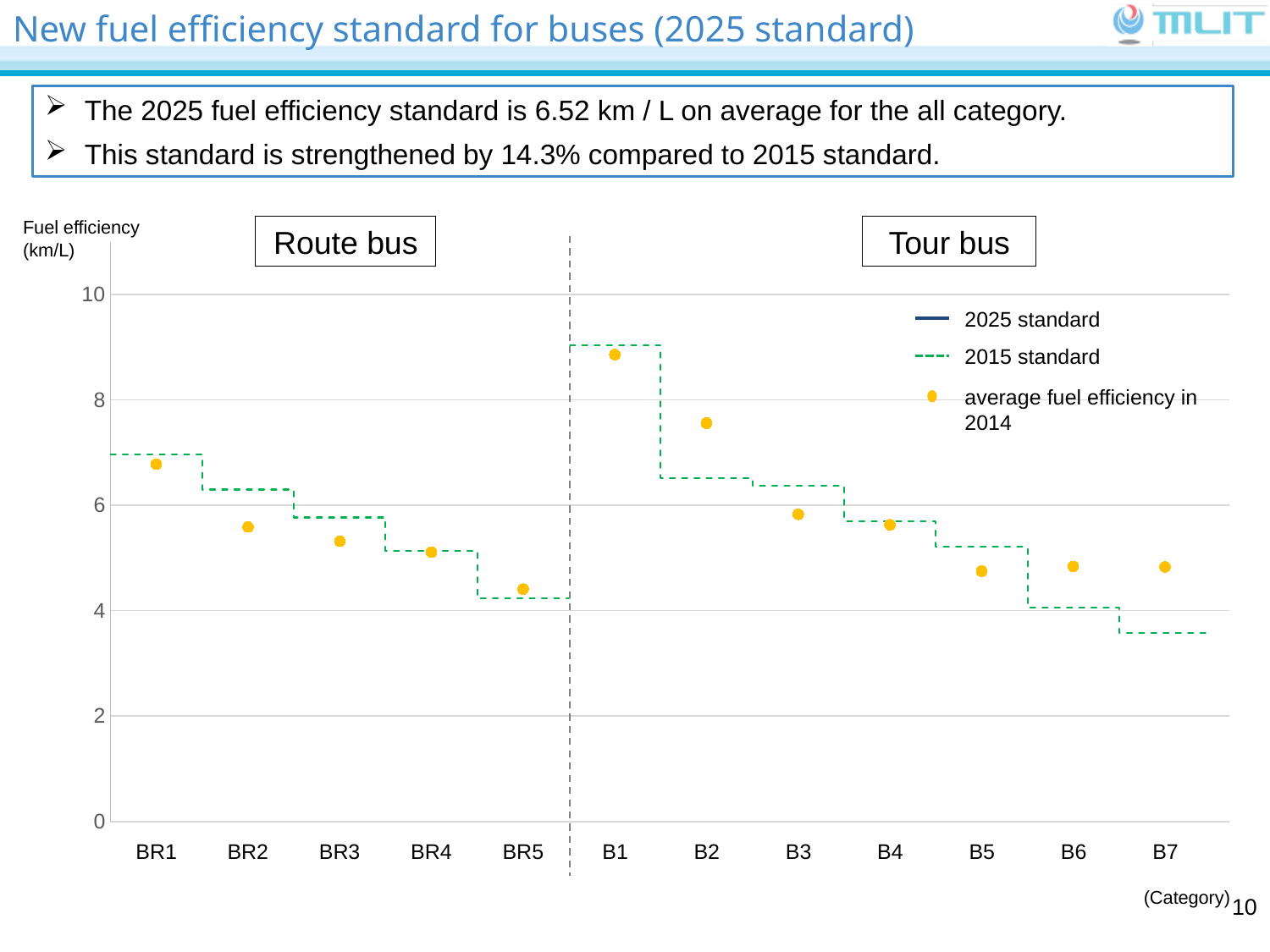
Does the 2015 standard rise or fall from B1 to B7? fall How many series does the chart legend list? 3 Which has the higher average fuel efficiency in 2014, BR1 or BR2? BR1 How many Route bus categories are shown on the chart? 5 How many categories are shown on the x axis of the chart? 12 Is the average fuel efficiency in 2014 for BR1 greater or less than 6? greater Is the average fuel efficiency in 2014 for B2 greater or less than 8? less What unit is the y axis of the chart measured in? km/L Is the average fuel efficiency in 2014 for B1 greater or less than 8? greater Which has the higher average fuel efficiency in 2014, B3 or B5? B3 Which category has the highest average fuel efficiency in 2014? B1